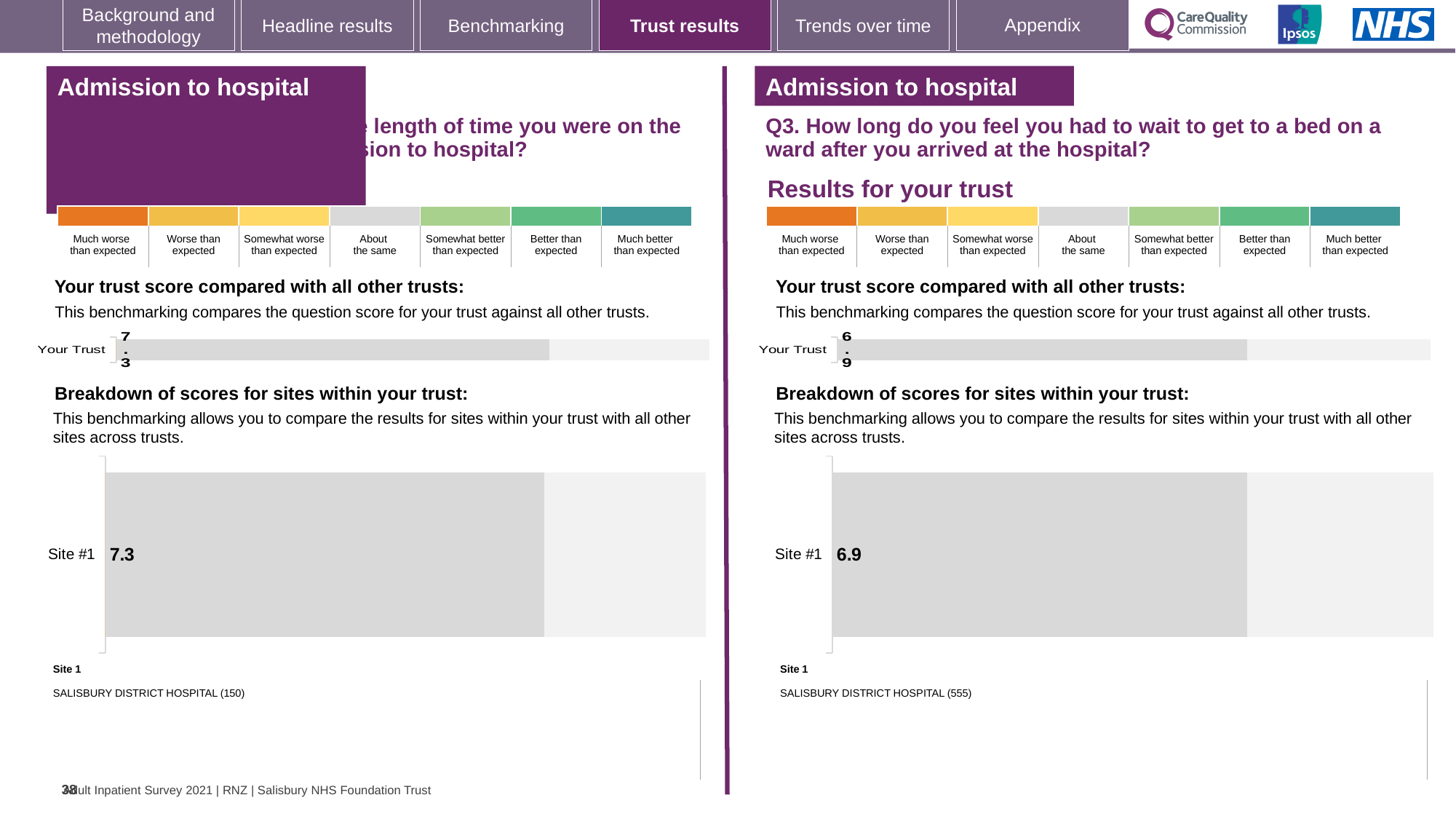
On the left panel, what is the score shown for Your Trust? 7.3 How many categories does the colour scale above the charts list, from 'Much worse than expected' to 'Much better than expected'? 7 Which site is listed as Site 1 on the right panel (Q3)? SALISBURY DISTRICT HOSPITAL (555) On the left panel's site breakdown chart, what is the score for Site #1? 7.3 Which is larger: the Your Trust score on the left panel or the Your Trust score on the right panel (Q3)? Left panel (7.3) On the left panel, is the Your Trust score equal to the Site #1 score? Yes What kind of chart is used to show the Site #1 score on the left panel? Bar chart What is the difference between the Site #1 score on the left panel and the Site #1 score on the right panel (Q3)? 0.4 On the right panel (Q3), what is the score shown for Your Trust? 6.9 How many sites are shown in the site breakdown chart on the right panel (Q3)? 1 On the right panel's site breakdown chart (Q3), what is the score for Site #1? 6.9